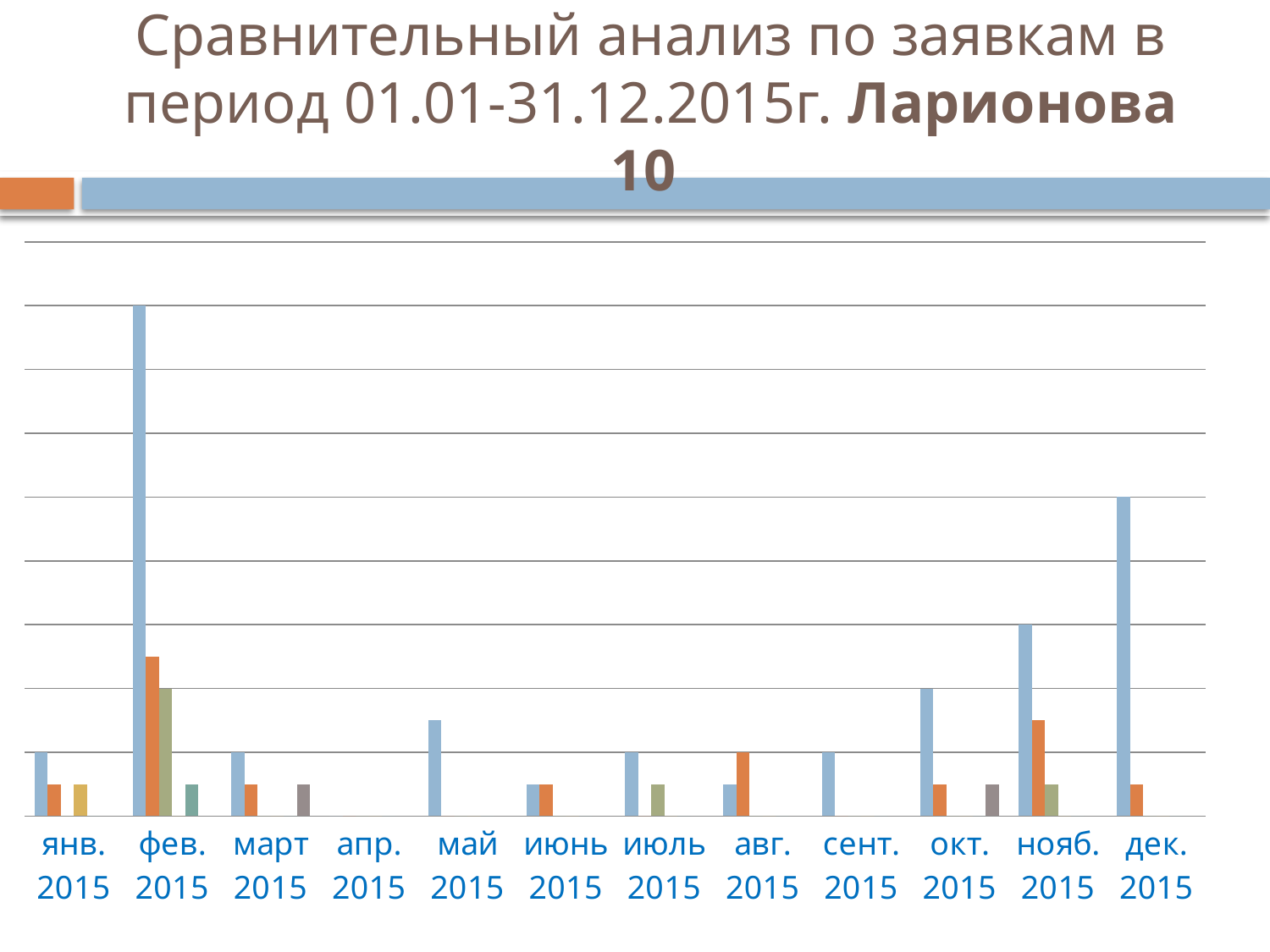
What kind of chart is shown on the slide? bar chart Which month has the tallest bar in the chart? фев. 2015 Which month shows no bars at all? апр. 2015 Is the blue bar taller for фев. 2015 or for дек. 2015? фев. 2015 Is the blue bar taller for нояб. 2015 or for окт. 2015? нояб. 2015 Is the blue bar taller for май 2015 or for март 2015? май 2015 How many months are shown along the x axis of the chart? 12 Does the chart display a legend? No Which month has the second tallest blue bar in the chart? дек. 2015 What is the title of the slide containing the chart? Сравнительный анализ по заявкам в период 01.01-31.12.2015г. Ларионова 10